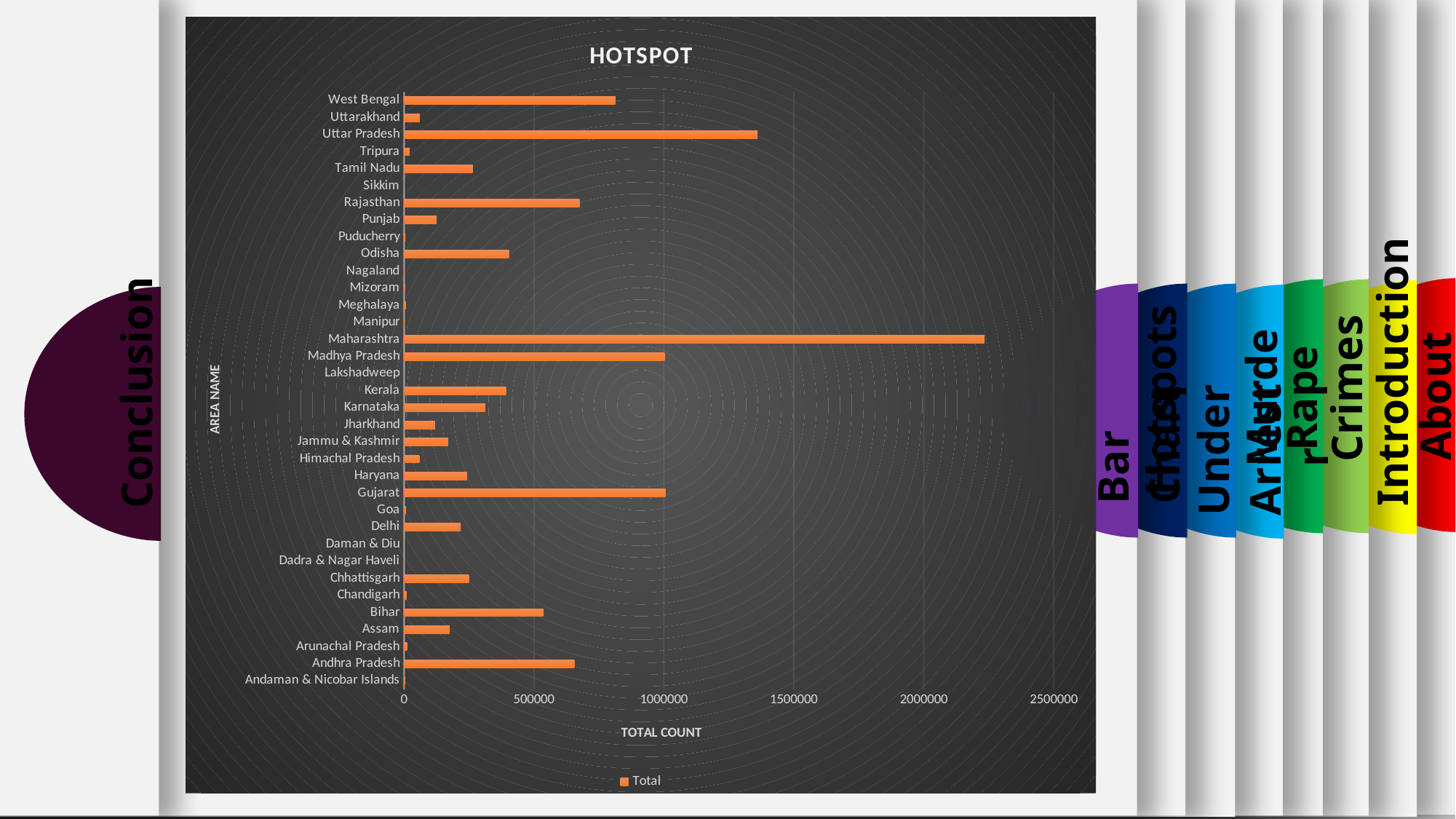
Which area has the highest total count? Maharashtra What is the label of the horizontal axis? TOTAL COUNT Which has a larger total count, Kerala or Karnataka? Kerala Is the value for Odisha greater or less than 500000? less What is the title of the chart? HOTSPOT Is the value for Maharashtra greater or less than 2000000? greater Is the value for Uttar Pradesh greater or less than 1000000? greater How many area names are plotted on the chart? 35 How many series does the legend list? 1 Which has a larger total count, Uttar Pradesh or West Bengal? Uttar Pradesh What kind of chart is shown on the slide? Bar chart